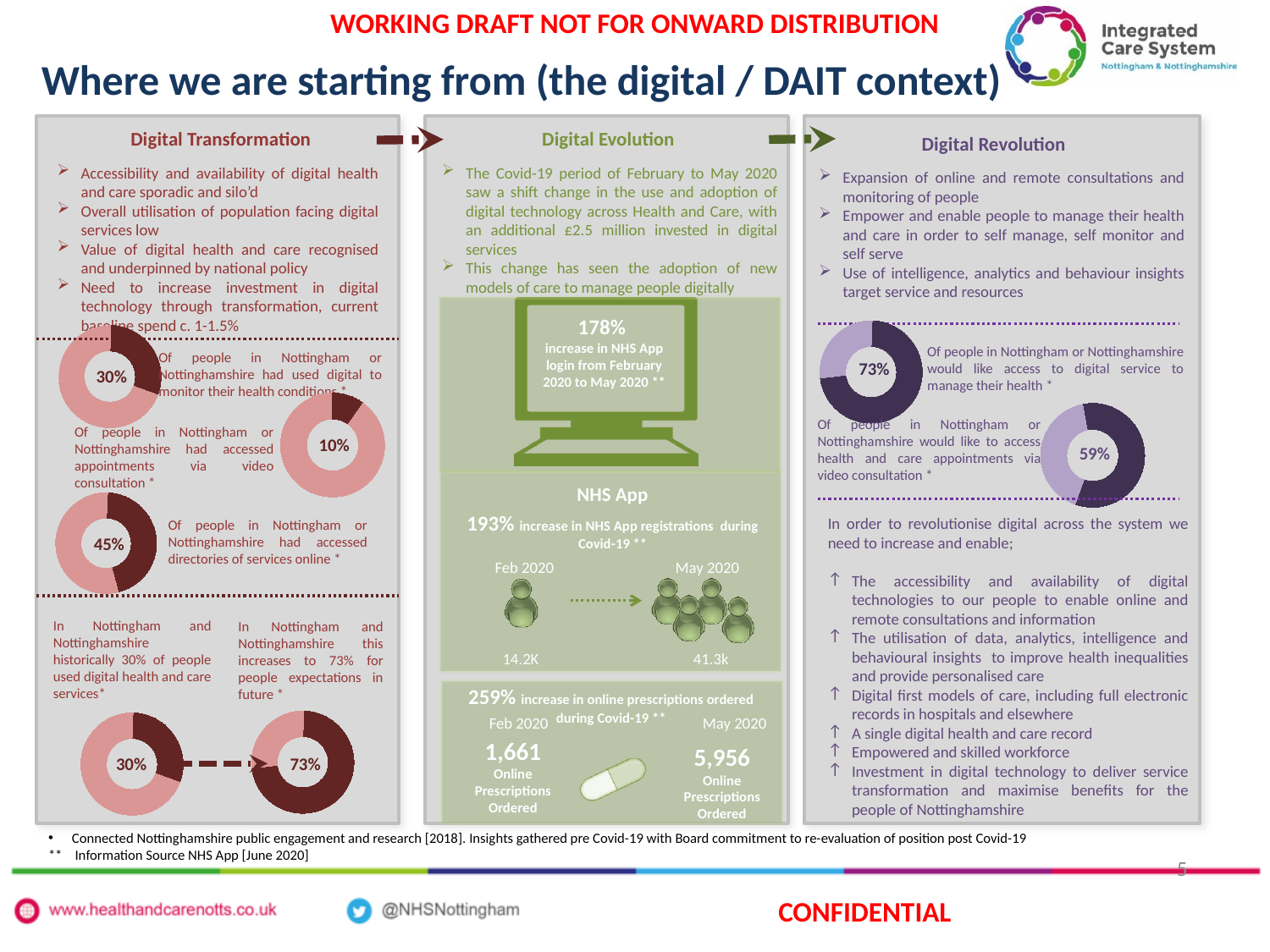
Among the three donut charts in the upper part of the Digital Transformation panel, which has the highest value? Accessed directories of services online (45%) In the bottom pair of donut charts in the Digital Transformation panel, what percentage do people's expectations increase to in future? 73% In the bottom pair of donut charts in the Digital Transformation panel, what is the historical percentage of people who used digital health and care services? 30% In the Digital Revolution panel, what percentage of people would like to access health and care appointments via video consultation, as shown in the donut chart? 59% In the Digital Revolution panel, what percentage of people would like access to digital service to manage their health, as shown in the donut chart? 73% What type of chart is used to show the 30%, 10% and 45% figures in the Digital Transformation panel? Donut (pie) chart In the Digital Transformation panel, what percentage of people in Nottingham or Nottinghamshire had used digital to monitor their health conditions, as shown in the top donut chart? 30% In the Digital Revolution panel, which donut chart shows the larger value: access to digital service to manage health, or video consultation appointments? Access to digital service to manage health (73%) Among the three donut charts in the upper part of the Digital Transformation panel (monitoring health conditions, video consultation appointments, online directories), which has the lowest value? Accessed appointments via video consultation (10%) In the Digital Transformation panel, what percentage of people had accessed appointments via video consultation, as shown in the donut chart? 10% What is the difference between the future expectation percentage (73%) and the historical usage percentage (30%) shown in the bottom pair of donut charts in the Digital Transformation panel? 43% In the Digital Transformation panel, what percentage of people had accessed directories of services online, as shown in the donut chart? 45%